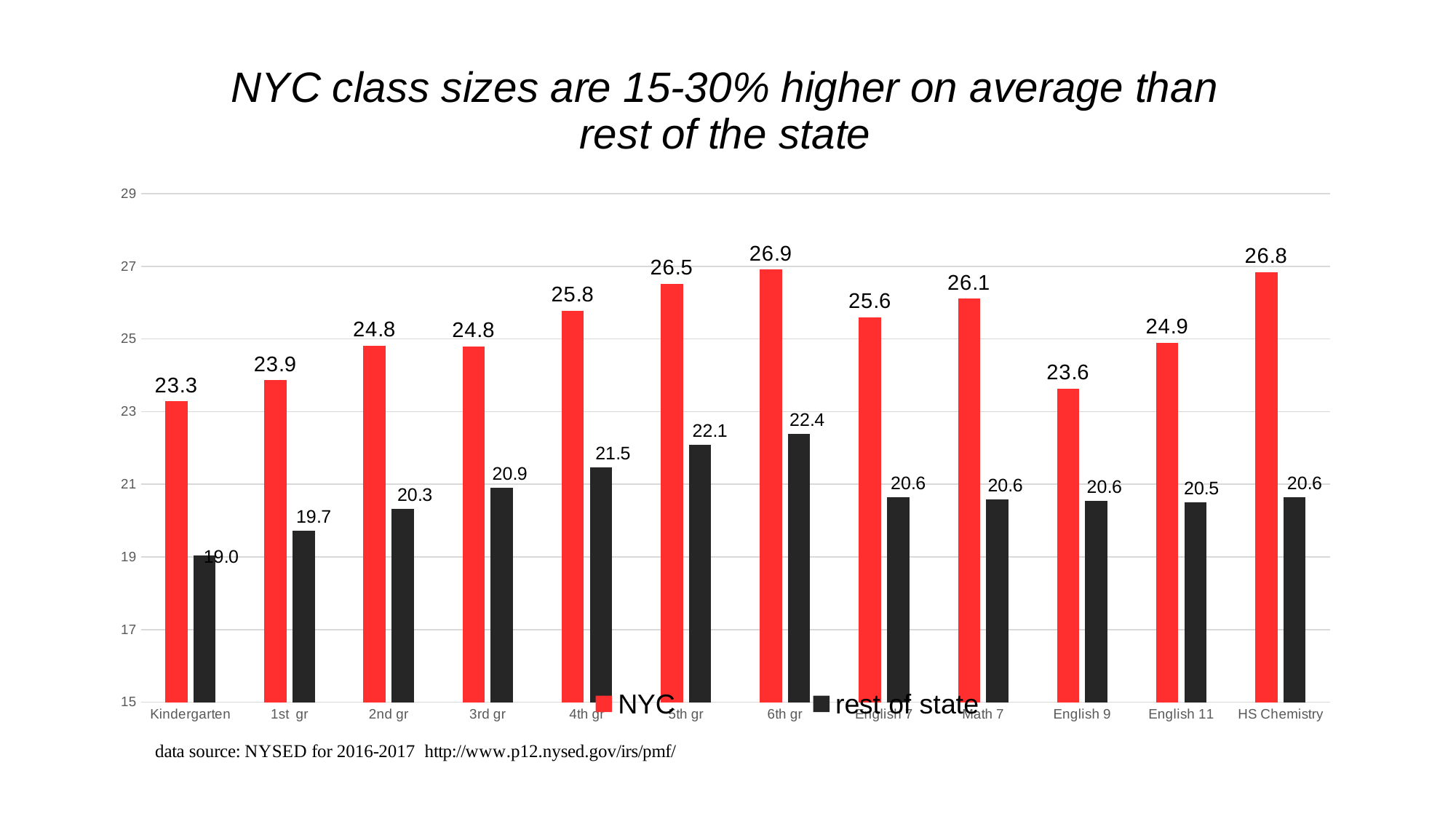
How many categories are shown on the x axis? 12 What is the rest of state class size for Kindergarten? 19.0 Which category has the lowest rest of state class size? Kindergarten What is the rest of state value for 4th gr? 21.5 Which category has the lowest NYC class size? Kindergarten Which category has the highest NYC class size? 6th gr What kind of chart is shown on the slide? bar chart What is the NYC class size for 6th gr? 26.9 What is the difference between the NYC and rest of state values for 6th gr? 4.5 How many series does the legend list? 2 What is the NYC value for HS Chemistry? 26.8 Which is larger, the NYC value for English 9 or the NYC value for English 11? English 11